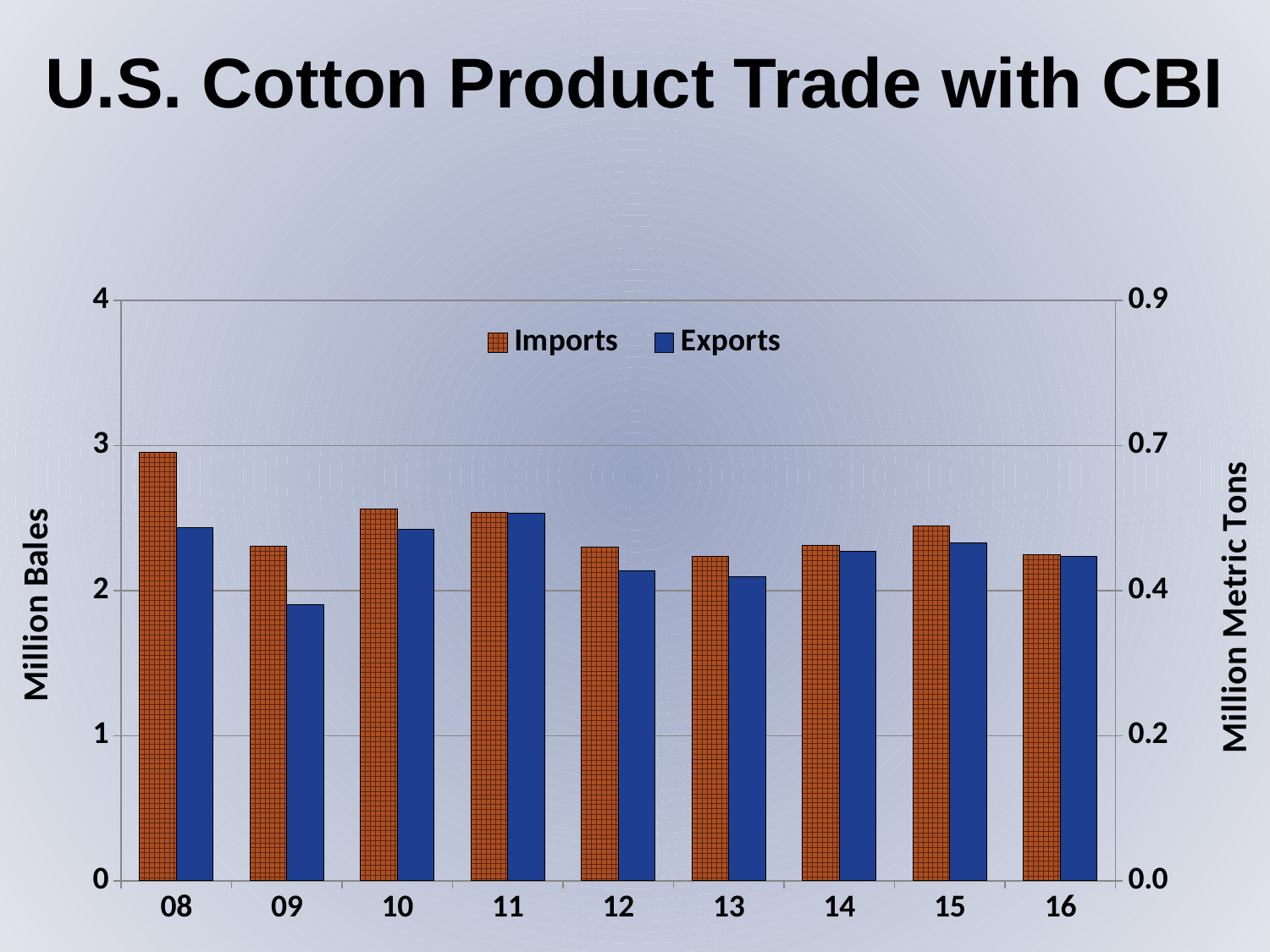
In 09, which is larger, Imports or Exports? Imports Is the value for Imports in 08 greater or less than 2 million bales? greater In 08, which is larger, Imports or Exports? Imports How many years are shown on the x axis? 9 In which year are Imports highest? 08 Is the value for Exports in 09 greater or less than 2 million bales? less In which year are Exports lowest? 09 How many series does the legend list? 2 What kind of chart is shown on the slide? bar chart What is the label on the left vertical axis? Million Bales Is the value for Exports in 11 greater or less than 2 million bales? greater Do Exports rise or fall from 11 to 13? fall